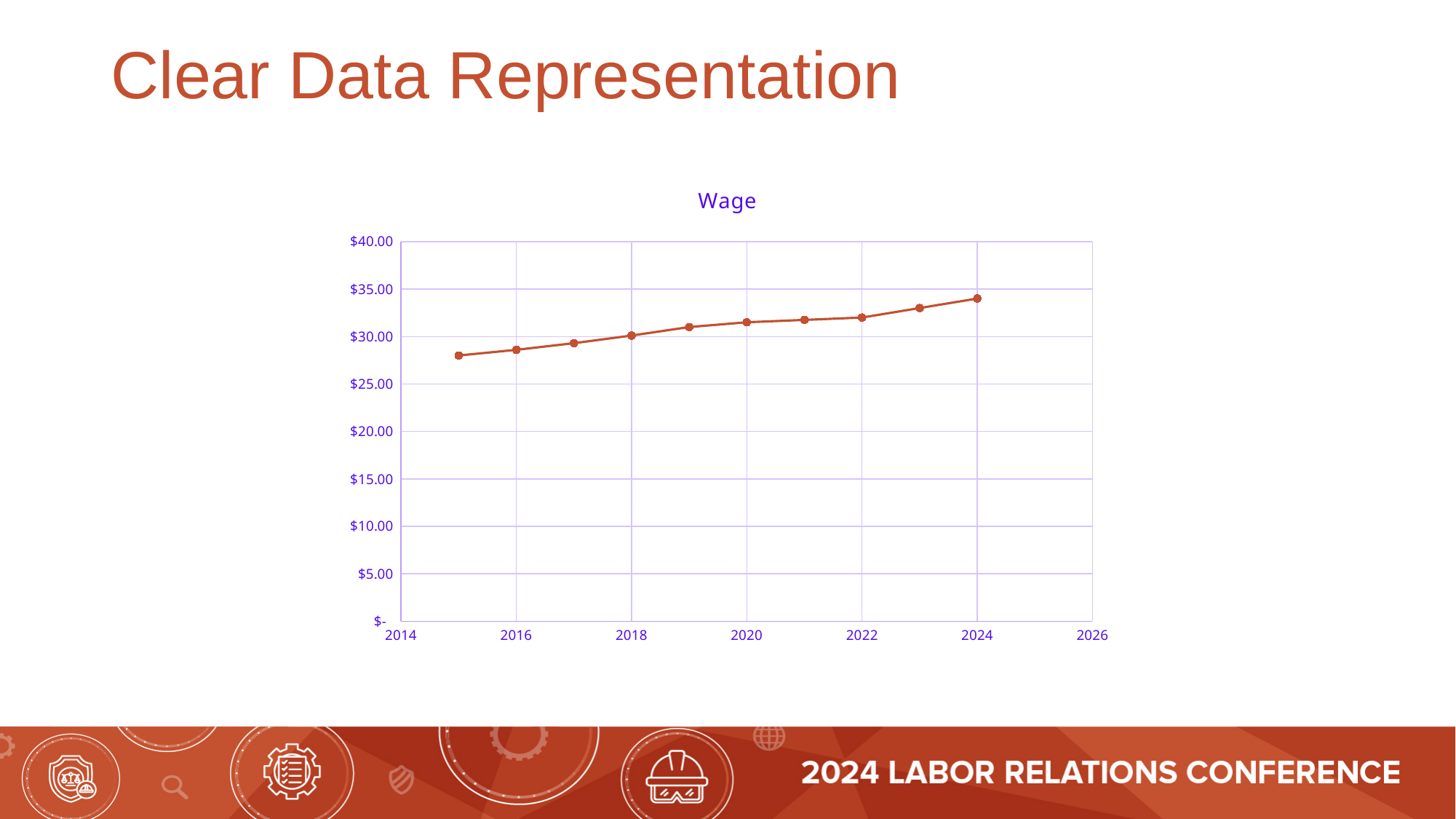
How many data points are plotted on the line? 10 Which year has the larger wage value, 2016 or 2023? 2023 Which year has the lowest wage value? 2015 Is the wage value for 2024 greater or less than $30.00? greater Is the wage value for 2020 greater or less than $35.00? less Do the wage values rise or fall from 2015 to 2024? Rise Is the wage value for 2015 greater or less than $30.00? less What kind of chart is shown on the slide? Line chart What is the highest value shown on the vertical axis? $40.00 What is the title of the chart? Wage Which year has the highest wage value? 2024